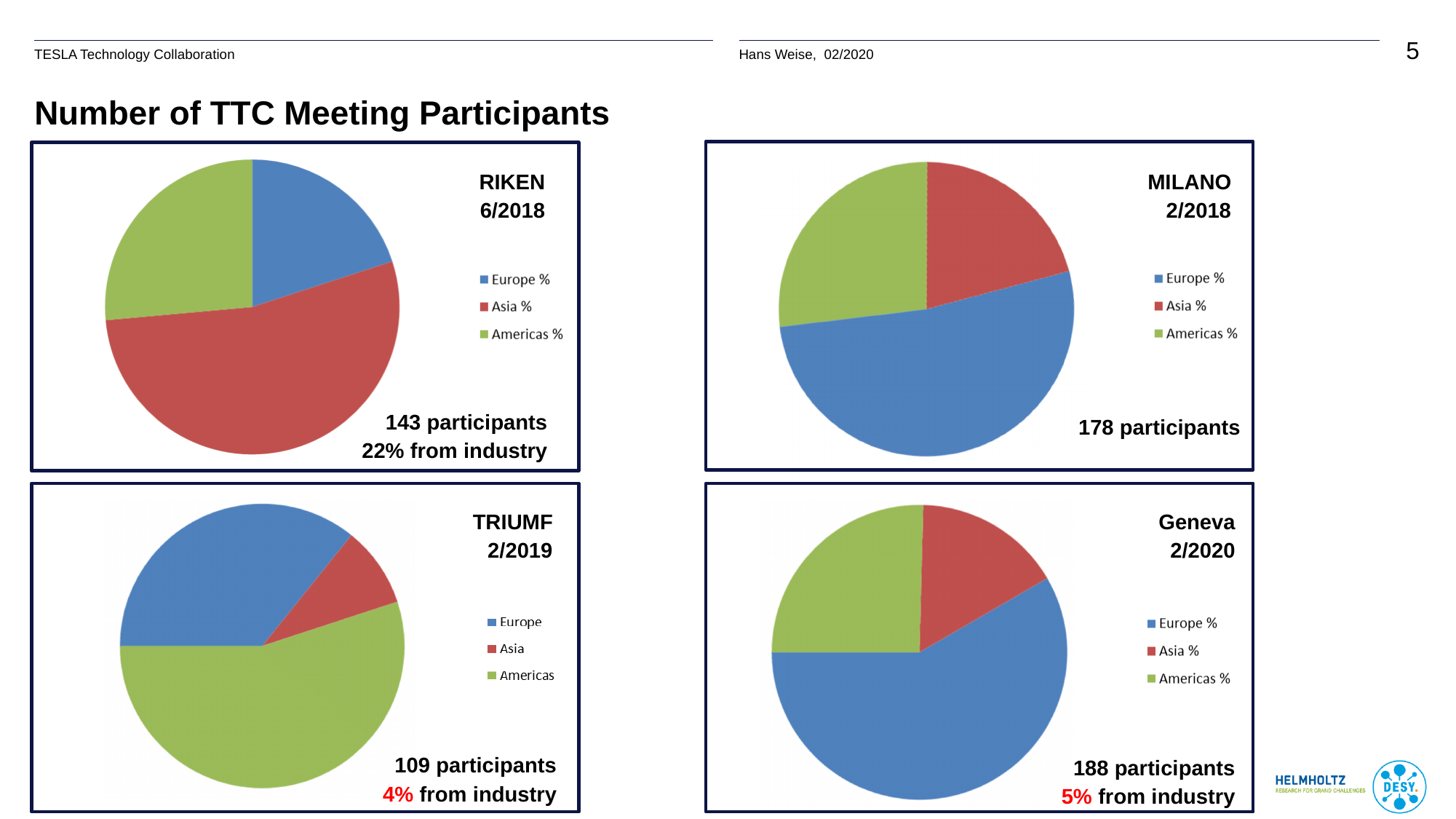
In the RIKEN 6/2018 pie chart, which region has the largest slice? Asia % How many charts are shown on the slide? 4 How many entries does the legend of the MILANO 2/2018 chart list? 3 In the Geneva 2/2020 pie chart, which slice is larger, Asia % or Americas %? Americas % In the Geneva 2/2020 pie chart, which region has the largest slice? Europe % What percentage of participants at the RIKEN 6/2018 meeting were from industry? 22% In the MILANO 2/2018 pie chart, which region has the largest slice? Europe % In the TRIUMF 2/2019 pie chart, which region has the smallest slice? Asia What kind of chart is the RIKEN 6/2018 chart? pie chart How many participants are stated for the Geneva 2/2020 meeting? 188 participants What is the title of the slide? Number of TTC Meeting Participants